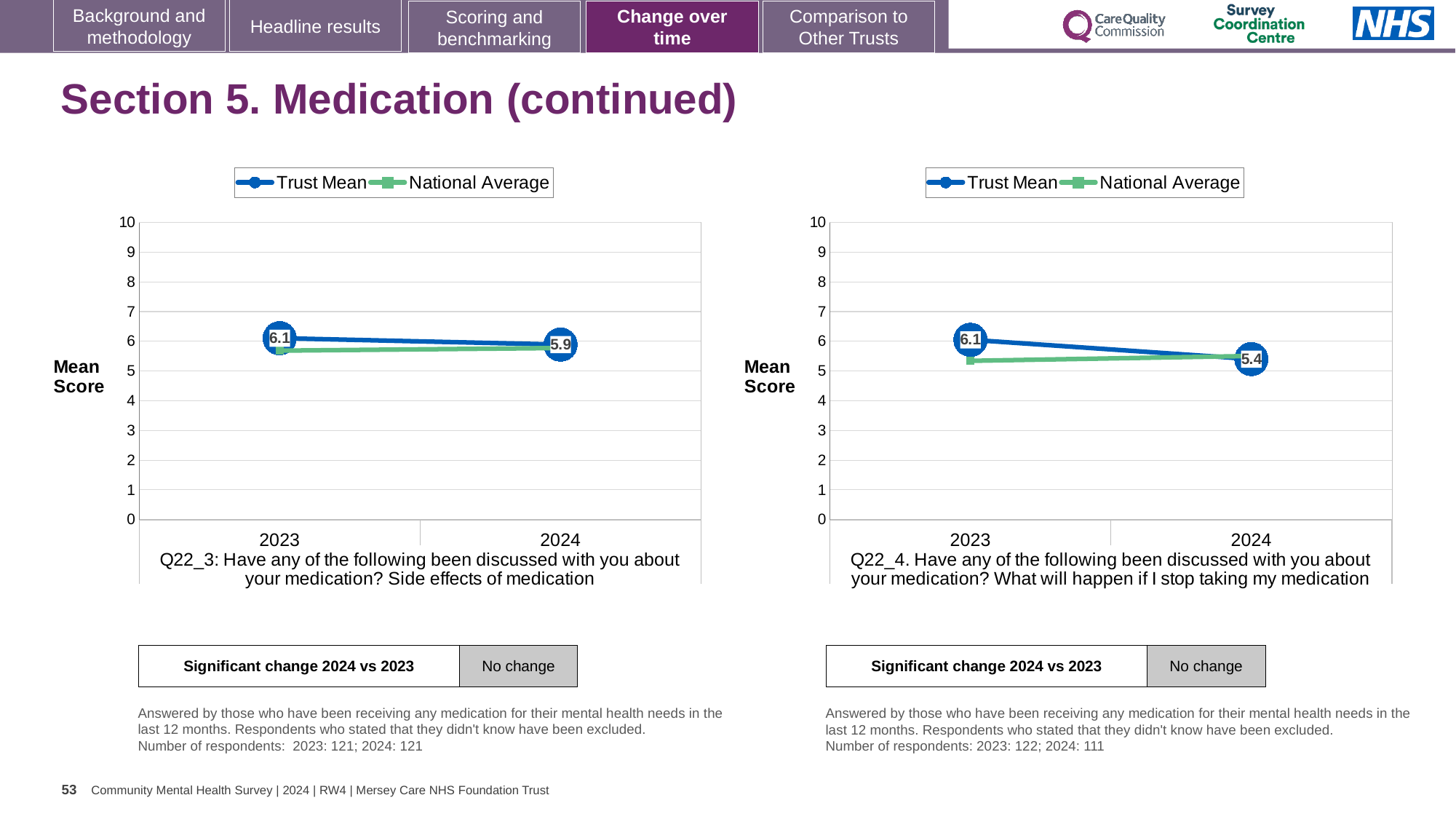
In the right chart (Q22_4), which is larger in 2023: the Trust Mean or the National Average? Trust Mean In the right chart (Q22_4), is the National Average for 2023 greater or less than 6? less In the right chart (Q22_4), what is the Trust Mean for 2024? 5.4 In the right chart (Q22_4), by how much did the Trust Mean change from 2023 to 2024? 0.7 In the right chart (Q22_4), what is the Trust Mean for 2023? 6.1 In the right chart (Q22_4), does the Trust Mean rise or fall from 2023 to 2024? fall In the left chart (Q22_3), what is the difference between the Trust Mean in 2023 and 2024? 0.2 In the left chart (Q22_3), what is the Trust Mean for 2023? 6.1 In the left chart (Q22_3), what is the Trust Mean for 2024? 5.9 How many series does the legend of the right chart (Q22_4) list? 2 What type of chart is used on the left side of the slide (Q22_3)? line chart How many years are plotted on the x axis of the left chart (Q22_3)? 2